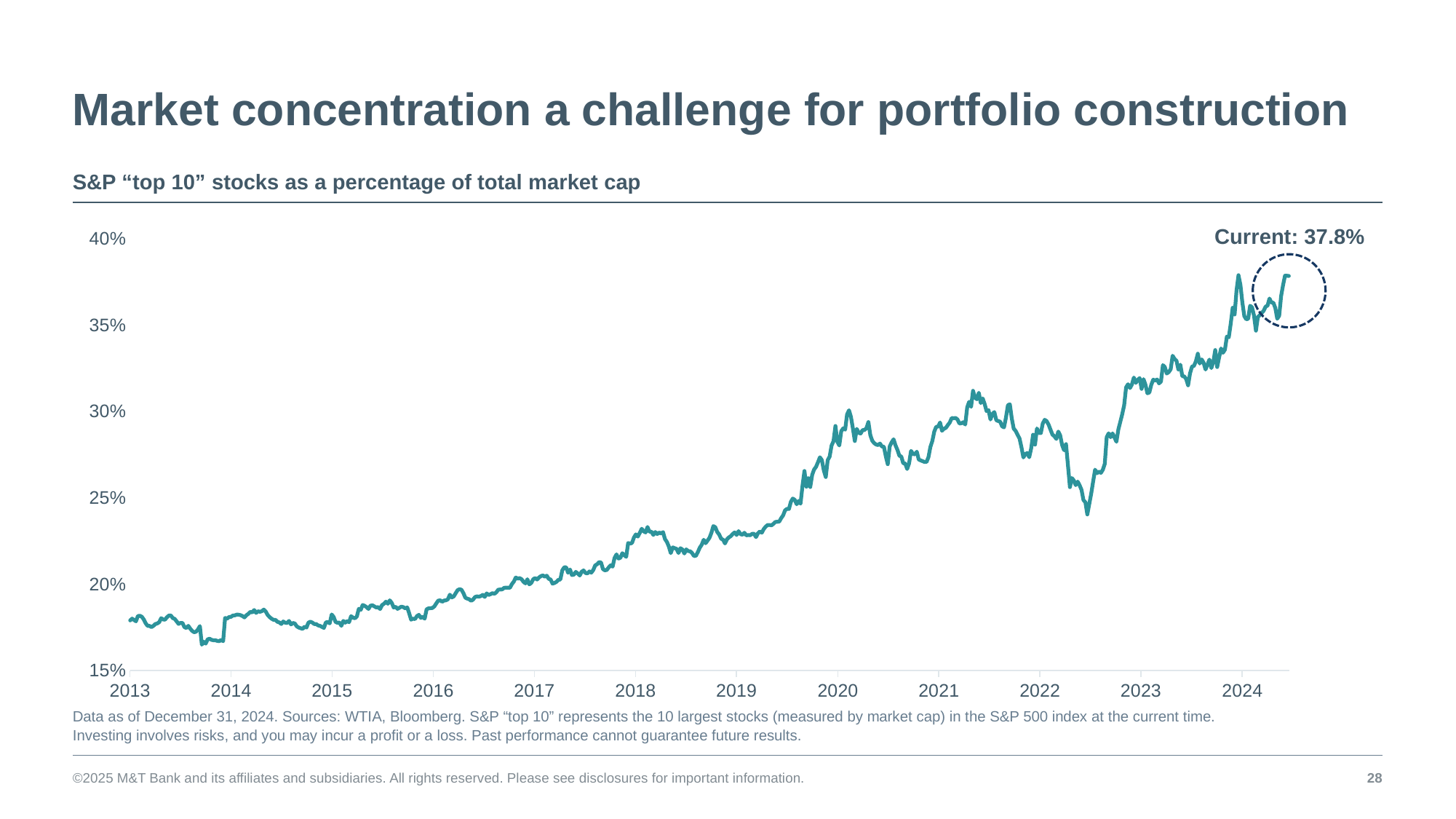
Which is larger: the value at the start of 2016 or the value at the start of 2021? 2021 What is the chart's subtitle describing the plotted series? S&P "top 10" stocks as a percentage of total market cap Is the value at the start of 2024 greater or less than 35%? less What is the current value of S&P "top 10" stocks as a percentage of total market cap, as labelled on the chart? 37.8% Is the value at the start of 2023 greater or less than 30%? less What is the first year labelled on the x axis? 2013 Does the S&P "top 10" share of total market cap generally rise or fall from 2013 to 2024? rise Is the value at the start of 2013 greater or less than 20%? less What kind of chart is shown on the slide? line chart What is the lowest value shown on the y axis? 15%